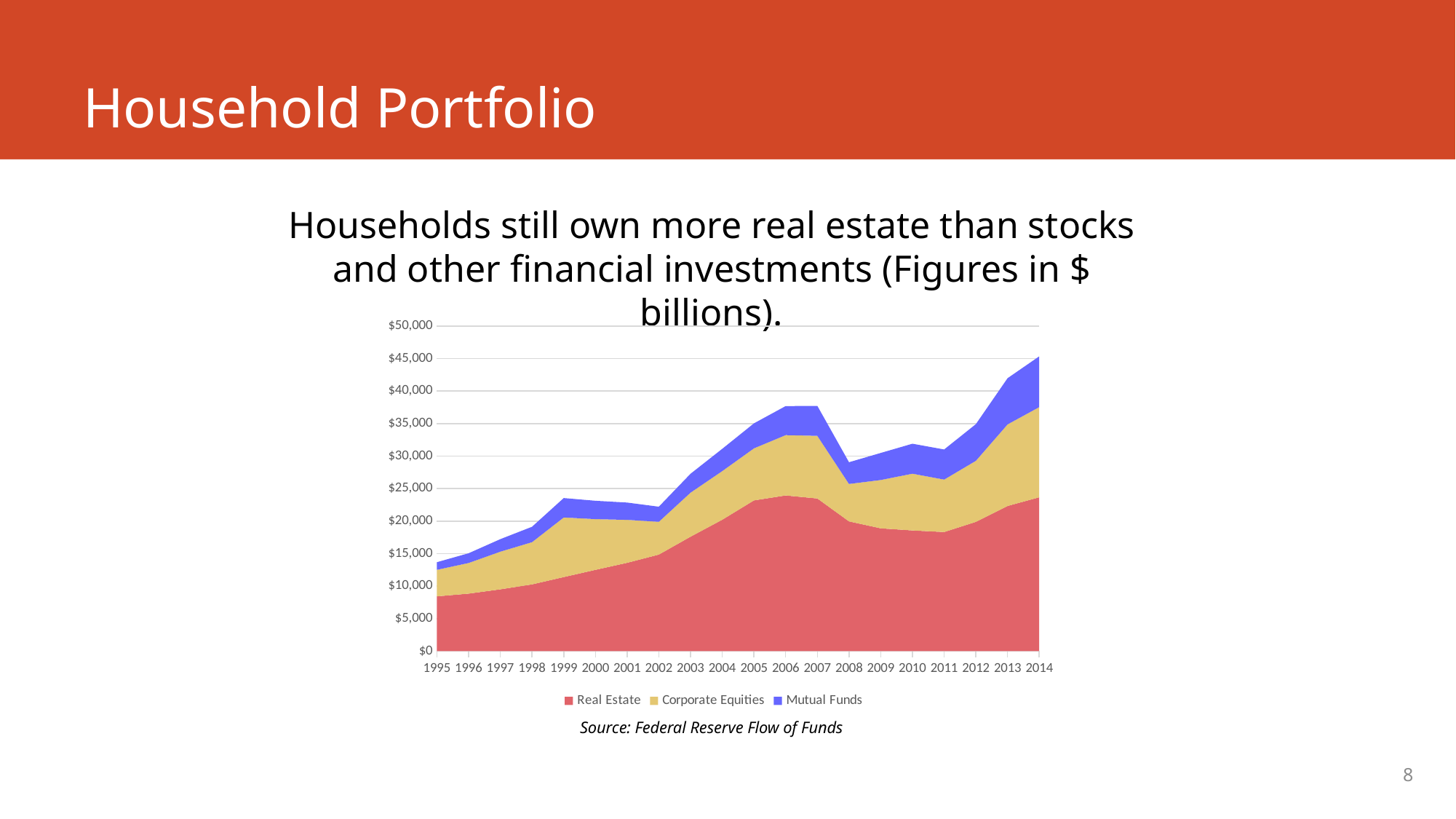
Is the Real Estate value for 1995 greater or less than $10,000? less In 2014, which is larger: the Real Estate value or the Mutual Funds value? Real Estate Is the total stacked value for 2014 greater or less than $40,000? greater Which year has the highest total stacked value in the chart? 2014 Which series is shown in red in the chart? Real Estate How many years are plotted along the x axis of the chart? 20 How many series does the chart's legend list? 3 Which year has the larger total stacked value, 2006 or 2008? 2006 Does the total stacked value rise or fall from 2011 to 2014? Rise Which year has the lowest total stacked value in the chart? 1995 Is the total stacked value for 2007 greater or less than $35,000? greater What kind of chart is shown on the slide? Stacked area chart